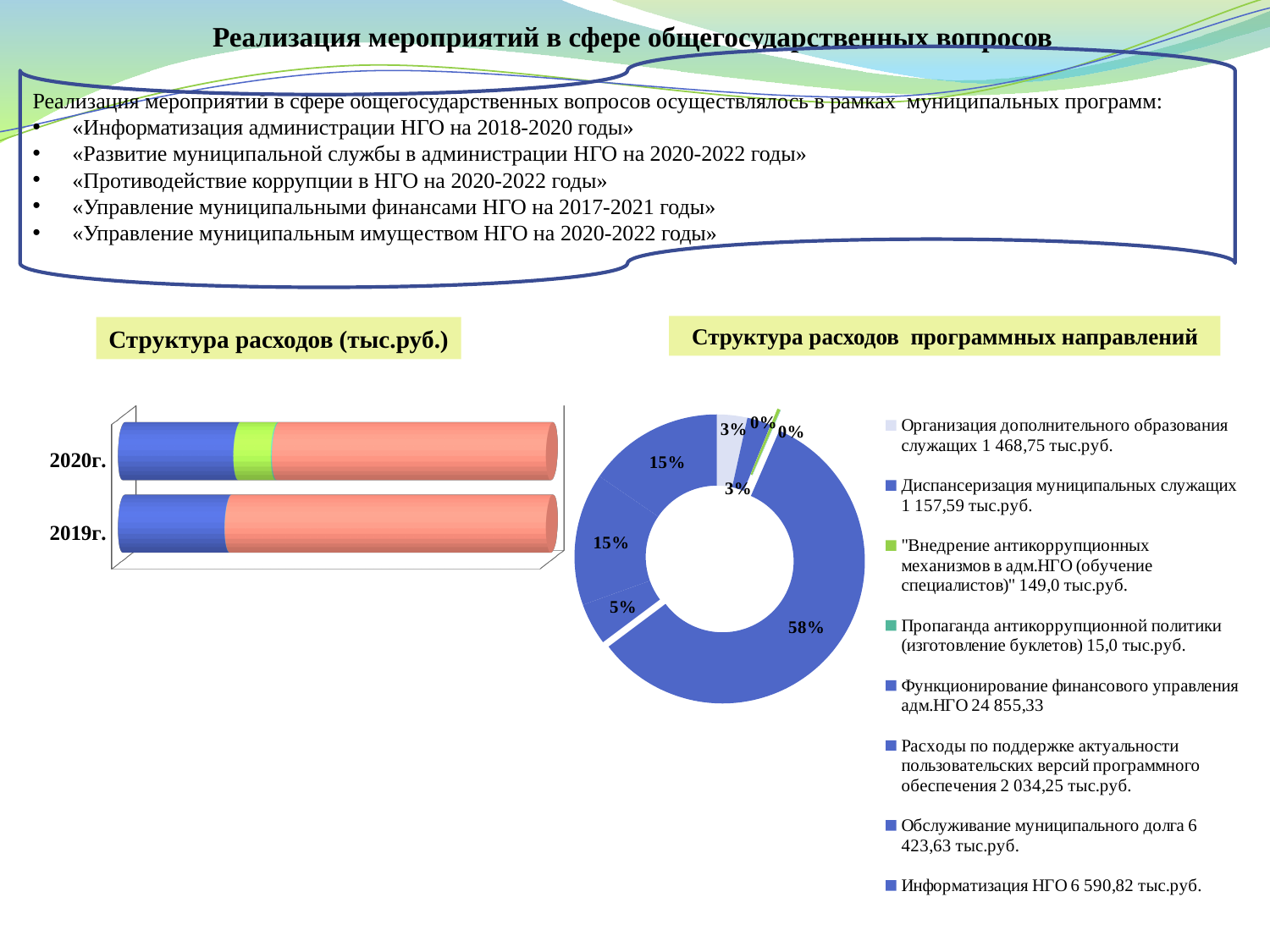
What type of chart is the 'Структура расходов (тыс.руб.)' chart on the left? bar chart What type of chart is the 'Структура расходов программных направлений' chart on the right? doughnut chart How many categories (years) are shown on the 'Структура расходов (тыс.руб.)' bar chart? 2 On the 'Структура расходов программных направлений' chart, which is larger according to the legend: 'Обслуживание муниципального долга' or 'Информатизация НГО'? Информатизация НГО On the 'Структура расходов (тыс.руб.)' bar chart, which year's bar contains a green segment? 2020г. How many entries does the legend of the 'Структура расходов программных направлений' chart list? 8 On the 'Структура расходов программных направлений' chart, what is the difference between the legend amounts for 'Организация дополнительного образования служащих' (1 468,75) and 'Диспансеризация муниципальных служащих' (1 157,59)? 311,16 тыс.руб. On the 'Структура расходов программных направлений' chart, which legend entry has the largest amount? Функционирование финансового управления адм.НГО 24 855,33 On the 'Структура расходов программных направлений' chart, what is the largest share shown? 58% On the 'Структура расходов программных направлений' chart, what amount is given in the legend for 'Информатизация НГО'? 6 590,82 тыс.руб. On the 'Структура расходов программных направлений' chart, what share does 'Организация дополнительного образования служащих' have? 3% On the 'Структура расходов программных направлений' chart, what amount is given in the legend for 'Пропаганда антикоррупционной политики (изготовление буклетов)'? 15,0 тыс.руб.